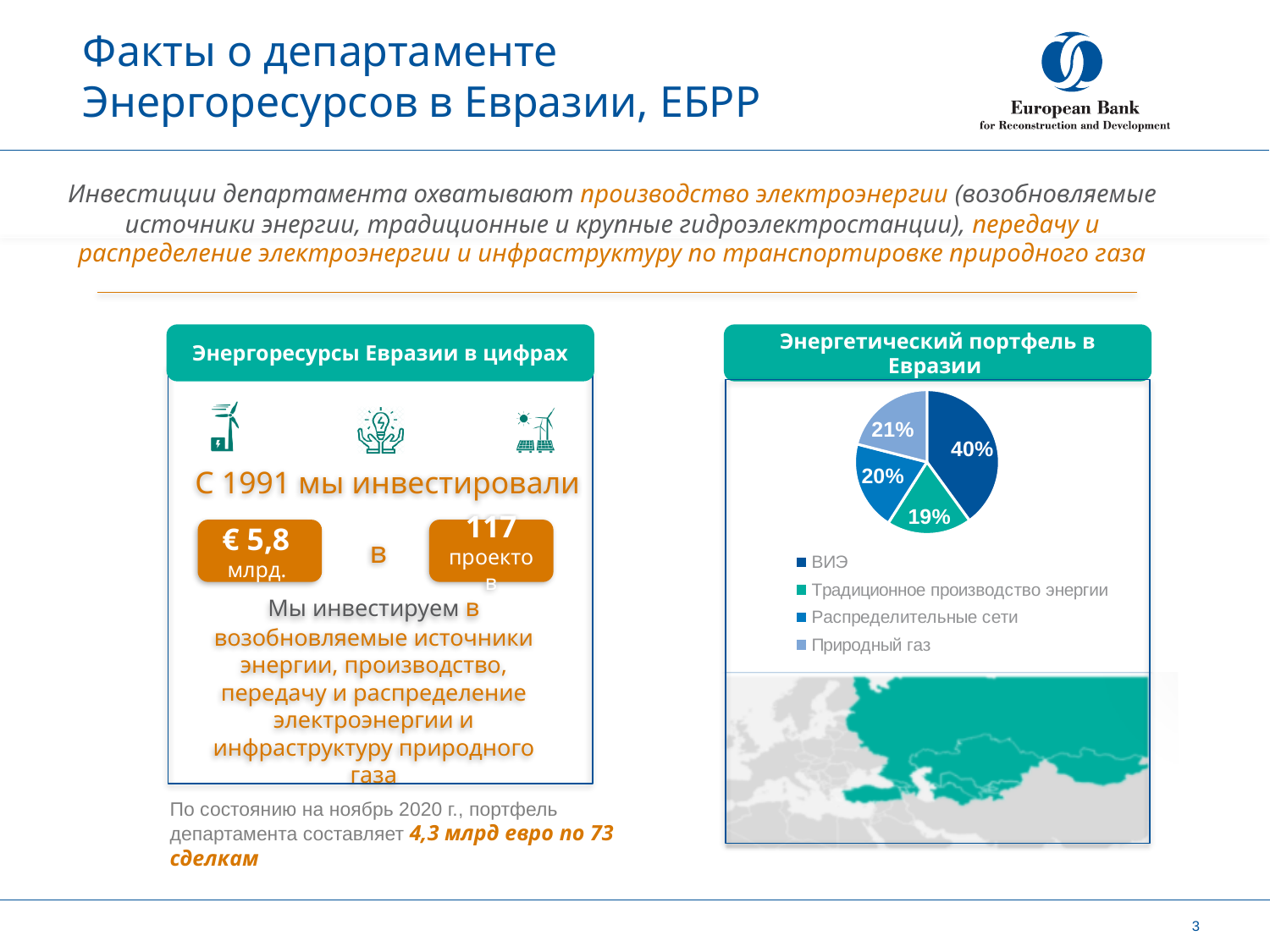
In the pie chart "Энергетический портфель в Евразии", what is the difference in percentage points between ВИЭ and Природный газ? 19 In the pie chart "Энергетический портфель в Евразии", what share does Распределительные сети have? 20% In the pie chart "Энергетический портфель в Евразии", which is larger: Распределительные сети or Традиционное производство энергии? Распределительные сети How many slices does the pie chart "Энергетический портфель в Евразии" have? 4 How many entries does the legend of the pie chart "Энергетический портфель в Евразии" list? 4 What kind of chart is shown under the title "Энергетический портфель в Евразии"? pie chart In the pie chart "Энергетический портфель в Евразии", what share does Природный газ have? 21% In the pie chart "Энергетический портфель в Евразии", what share does Традиционное производство энергии have? 19% In the pie chart "Энергетический портфель в Евразии", what colour is the ВИЭ slice? dark blue In the pie chart "Энергетический портфель в Евразии", which category has the largest share? ВИЭ In the pie chart "Энергетический портфель в Евразии", which category has the smallest share? Традиционное производство энергии In the pie chart "Энергетический портфель в Евразии", what share does ВИЭ have? 40%